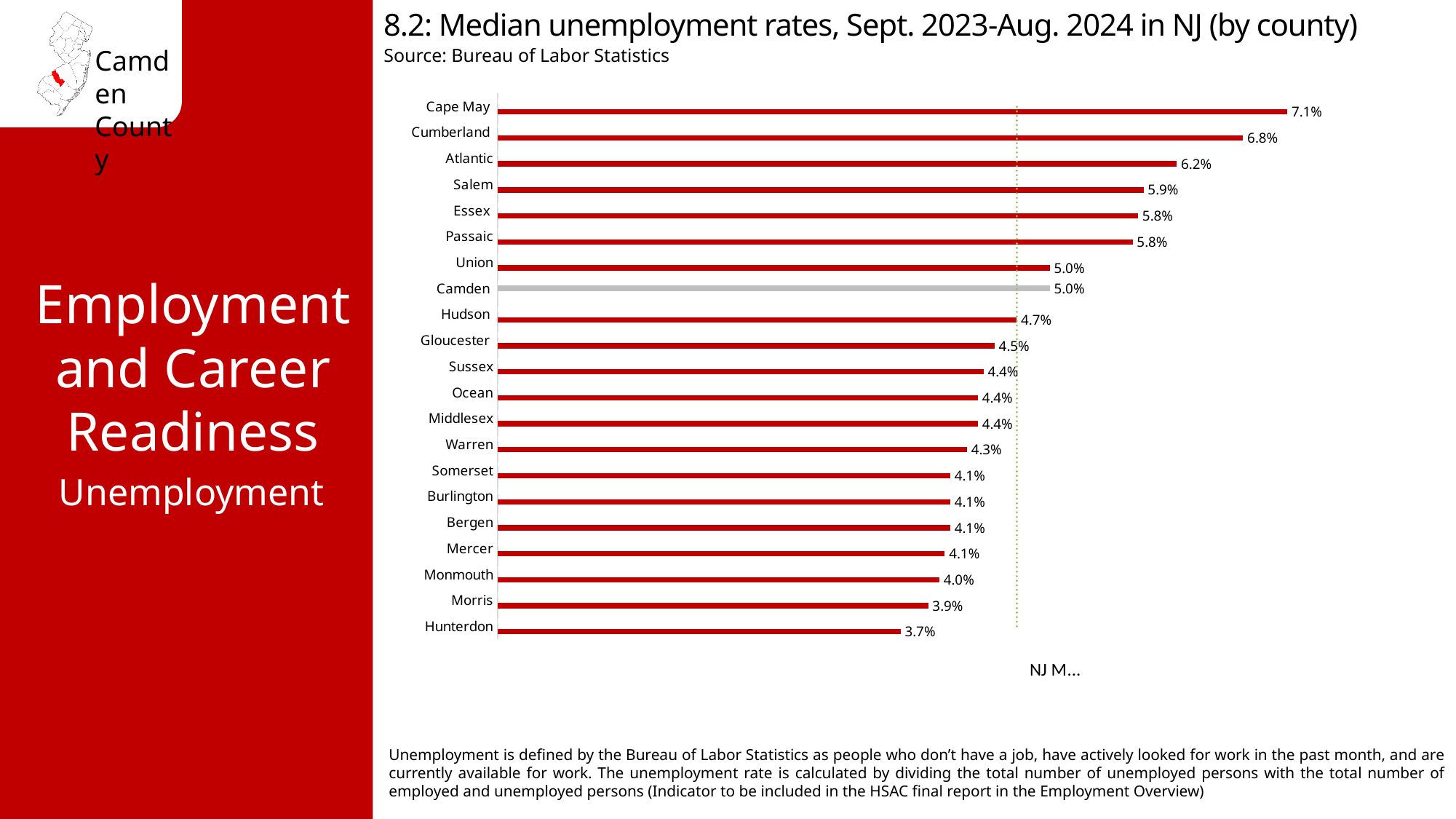
What is the median unemployment rate for Gloucester? 4.5% Which county has a higher median unemployment rate, Atlantic or Salem? Atlantic Which county has the highest median unemployment rate? Cape May What is the median unemployment rate for Camden County? 5.0% Which county's bar is shown in gray rather than red? Camden What is the median unemployment rate for Cape May? 7.1% What is the median unemployment rate for Hunterdon? 3.7% How many counties are shown in the chart? 21 What type of chart is used to show the median unemployment rates? Bar chart What is the difference between the median unemployment rates of Cape May and Hunterdon? 3.4% Which county has the lowest median unemployment rate? Hunterdon What is the difference between the median unemployment rates of Cumberland and Camden? 1.8%